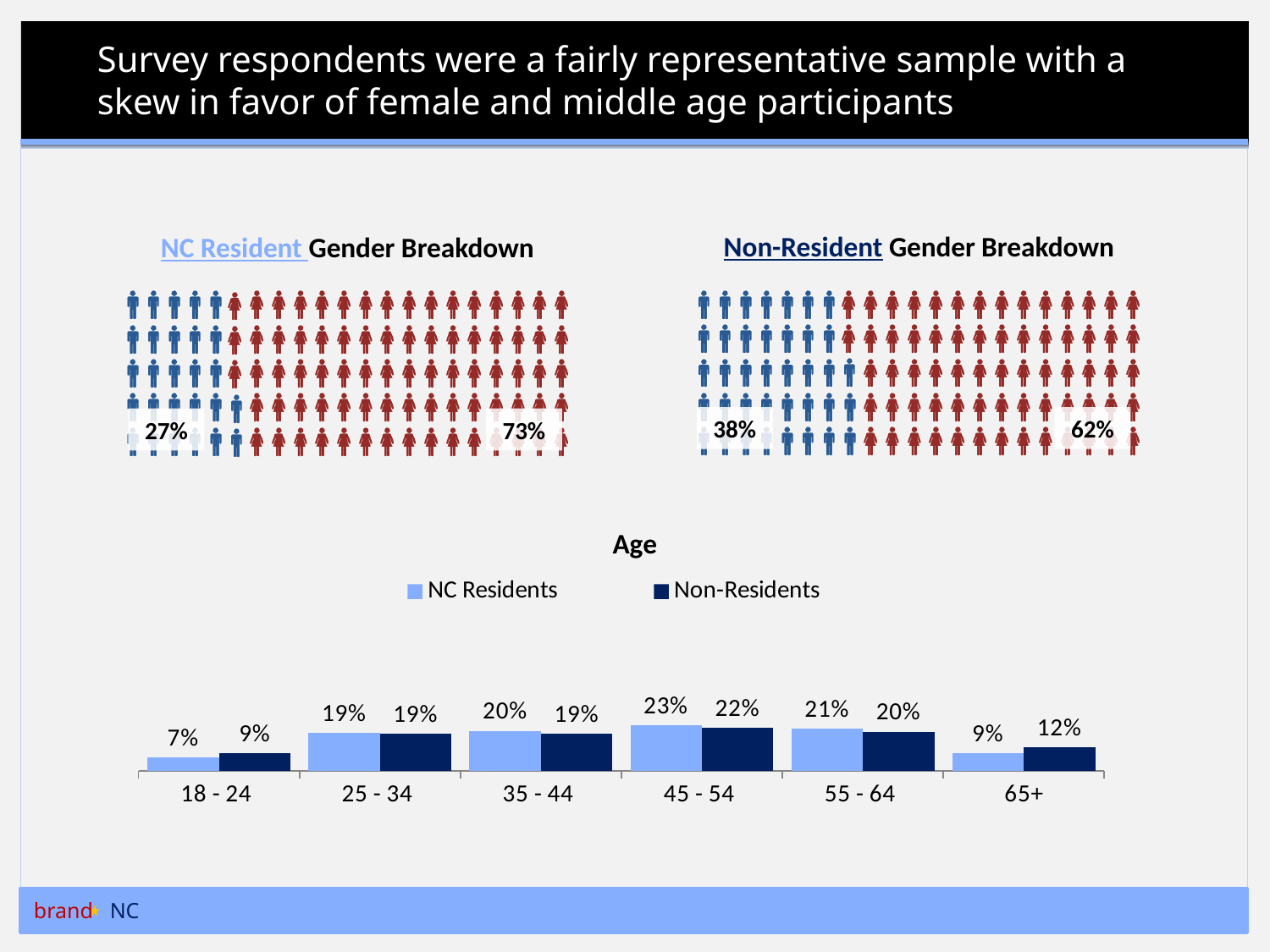
In the Age chart, which age group has the highest value for NC Residents? 45 - 54 In the Age chart, which age group has the lowest value for Non-Residents? 18 - 24 In the Age chart, which is larger for the 18 - 24 age group: NC Residents or Non-Residents? Non-Residents How many age groups are shown on the x axis of the Age chart? 6 In the NC Resident Gender Breakdown chart, what percentage is shown on the right side, next to the red figures? 73% In the Age chart, what is the value for NC Residents in the 45 - 54 age group? 23% How many series does the legend of the Age chart list? 2 What kind of chart is the Age chart? Bar chart In the Age chart, what is the value for Non-Residents in the 65+ age group? 12% In the Age chart, what is the difference between the NC Residents and Non-Residents values for the 65+ age group? 3% What are the two series named in the legend of the Age chart? NC Residents and Non-Residents In the Non-Resident Gender Breakdown chart, what percentage is shown on the left side, next to the blue figures? 38%